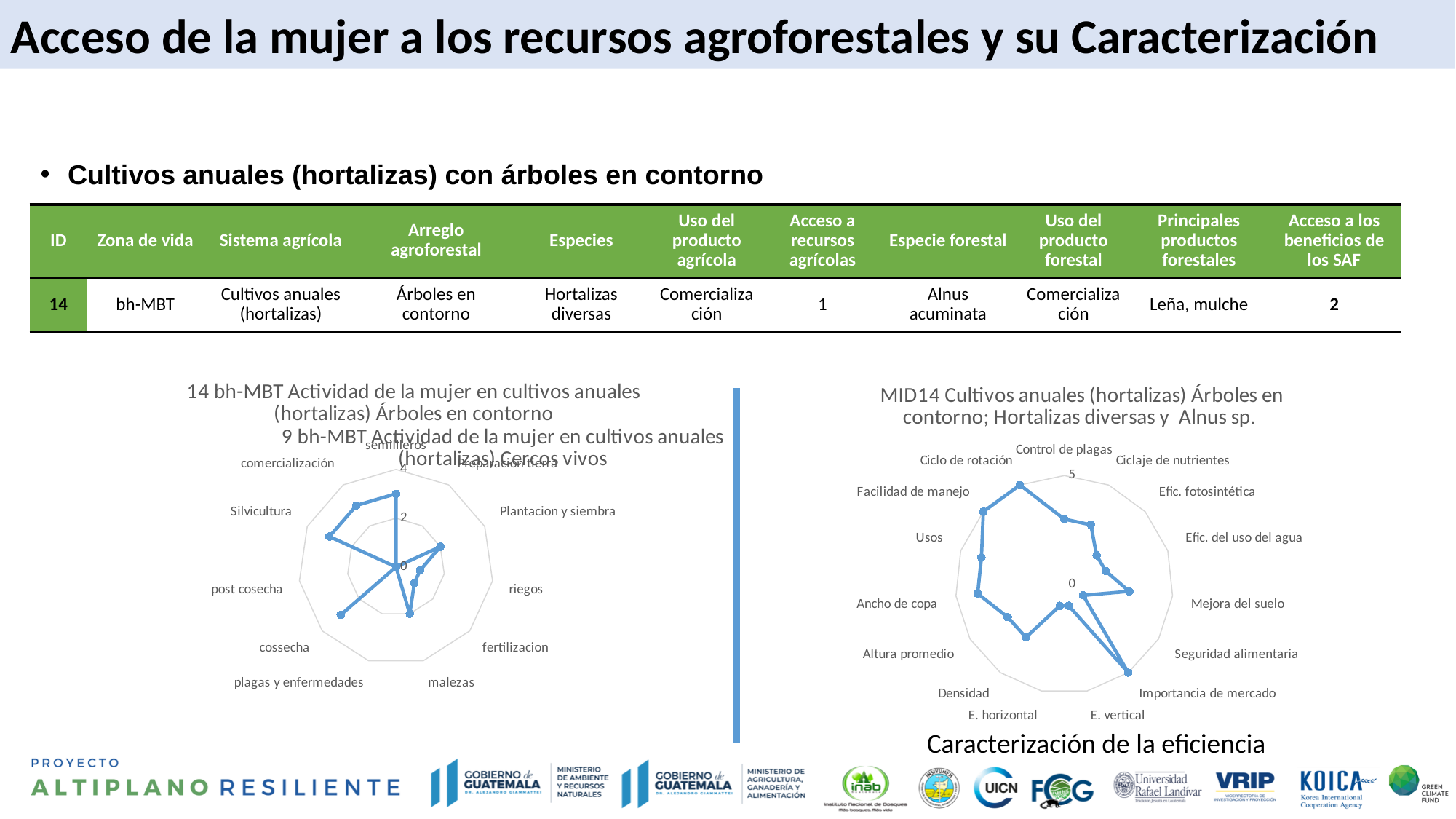
In the left chart (14 bh-MBT Actividad de la mujer), how many categories are plotted around the radar? 11 In the left chart (14 bh-MBT Actividad de la mujer), is the value for cossecha greater or less than 2? greater In the left chart (14 bh-MBT Actividad de la mujer), is the value for riegos greater or less than 2? less In the left chart (14 bh-MBT Actividad de la mujer), which is larger, the value for cossecha or the value for riegos? cossecha In the right chart (MID14 Cultivos anuales), which is larger, the value for Importancia de mercado or the value for E. vertical? Importancia de mercado What kind of chart is the left chart titled '14 bh-MBT Actividad de la mujer en cultivos anuales (hortalizas) Árboles en contorno'? Radar chart In the right chart (MID14 Cultivos anuales), is the value for E. vertical greater or less than 5? less What is the highest axis tick value shown on the right chart (MID14 Cultivos anuales)? 5 In the right chart (MID14 Cultivos anuales), how many categories are plotted around the radar? 15 What kind of chart is the right chart titled 'MID14 Cultivos anuales (hortalizas) Árboles en contorno; Hortalizas diversas y Alnus sp.'? Radar chart